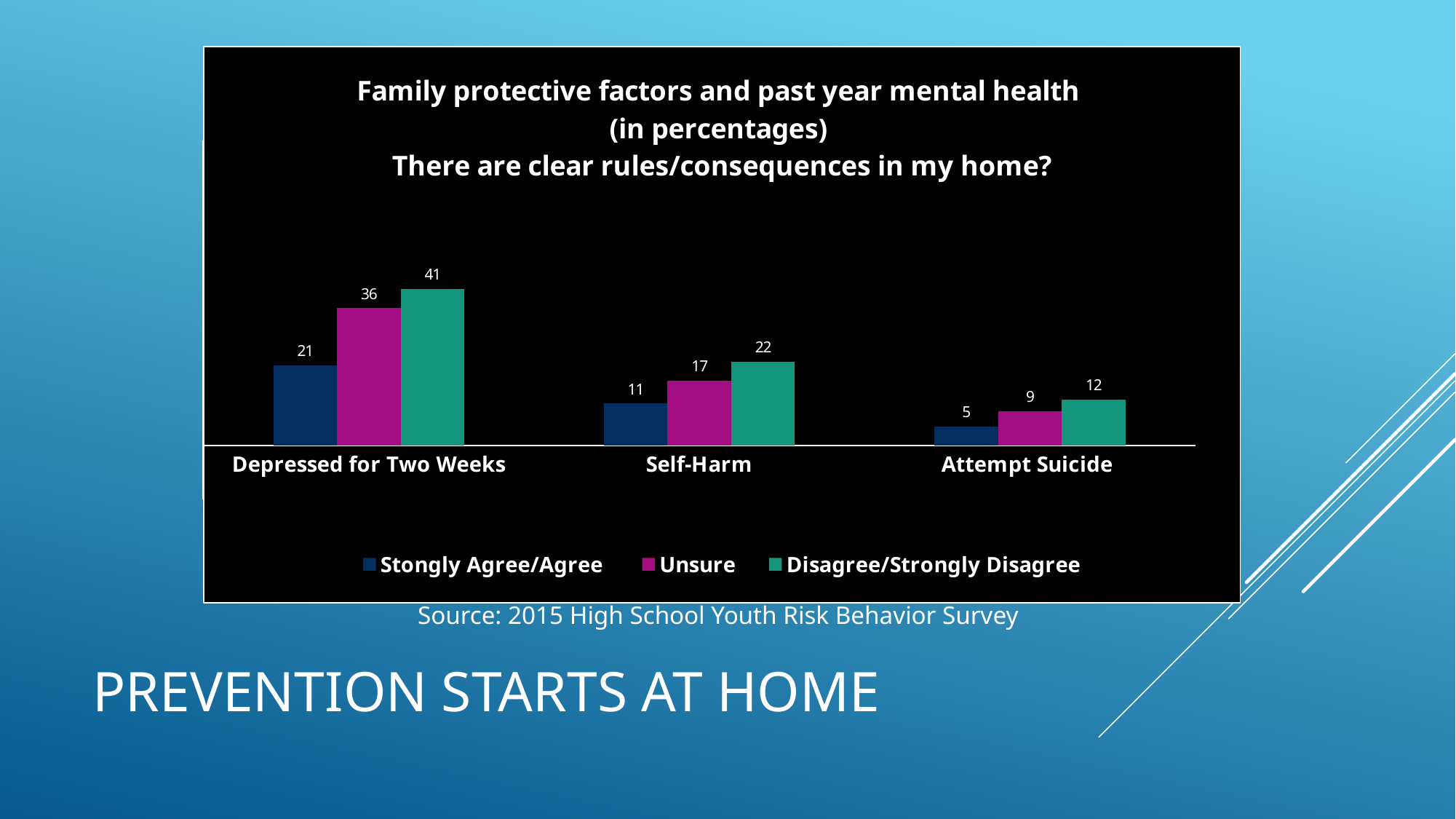
Which category has the lowest value for Stongly Agree/Agree? Attempt Suicide Which category has the highest value for Disagree/Strongly Disagree? Depressed for Two Weeks What is the difference between the Unsure and Stongly Agree/Agree values for Self-Harm? 6 What is the difference between the Disagree/Strongly Disagree and Stongly Agree/Agree values for Depressed for Two Weeks? 20 What is the value for Stongly Agree/Agree in the Attempt Suicide category? 5 What is the value for Disagree/Strongly Disagree in the Self-Harm category? 22 How many series does the legend list? 3 What kind of chart is shown on the slide? Bar chart How many categories are shown on the x axis? 3 Which series is shown in magenta in the legend? Unsure Which is larger for Attempt Suicide: Unsure or Disagree/Strongly Disagree? Disagree/Strongly Disagree What is the value for Unsure in the Depressed for Two Weeks category? 36